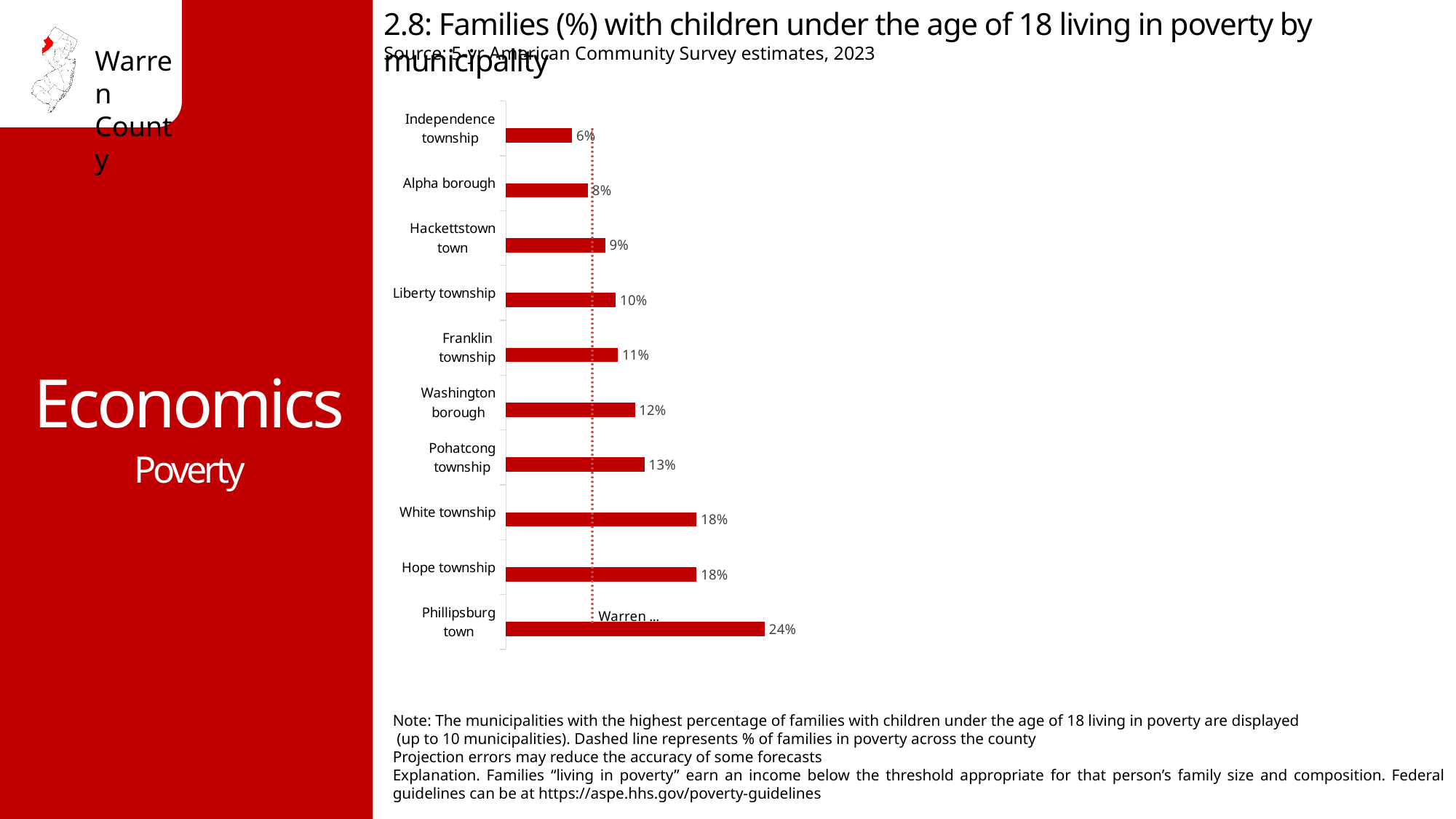
What is the value for Phillipsburg town? 24% What is the value for Hackettstown town? 9% What is the difference between the values for Phillipsburg town and Pohatcong township? 11% What is the value for Alpha borough? 8% What is the value for Washington borough? 12% What does the dashed vertical line in the chart represent? % of families in poverty across the county How many municipalities are shown in the chart? 10 Which municipality has the lowest percentage of families with children under 18 living in poverty? Independence township What is the difference between the values for White township and Liberty township? 8% What kind of chart is shown on the slide? Bar chart Which municipality has the highest percentage of families with children under 18 living in poverty? Phillipsburg town Which is larger, the value for Franklin township or the value for Hackettstown town? Franklin township